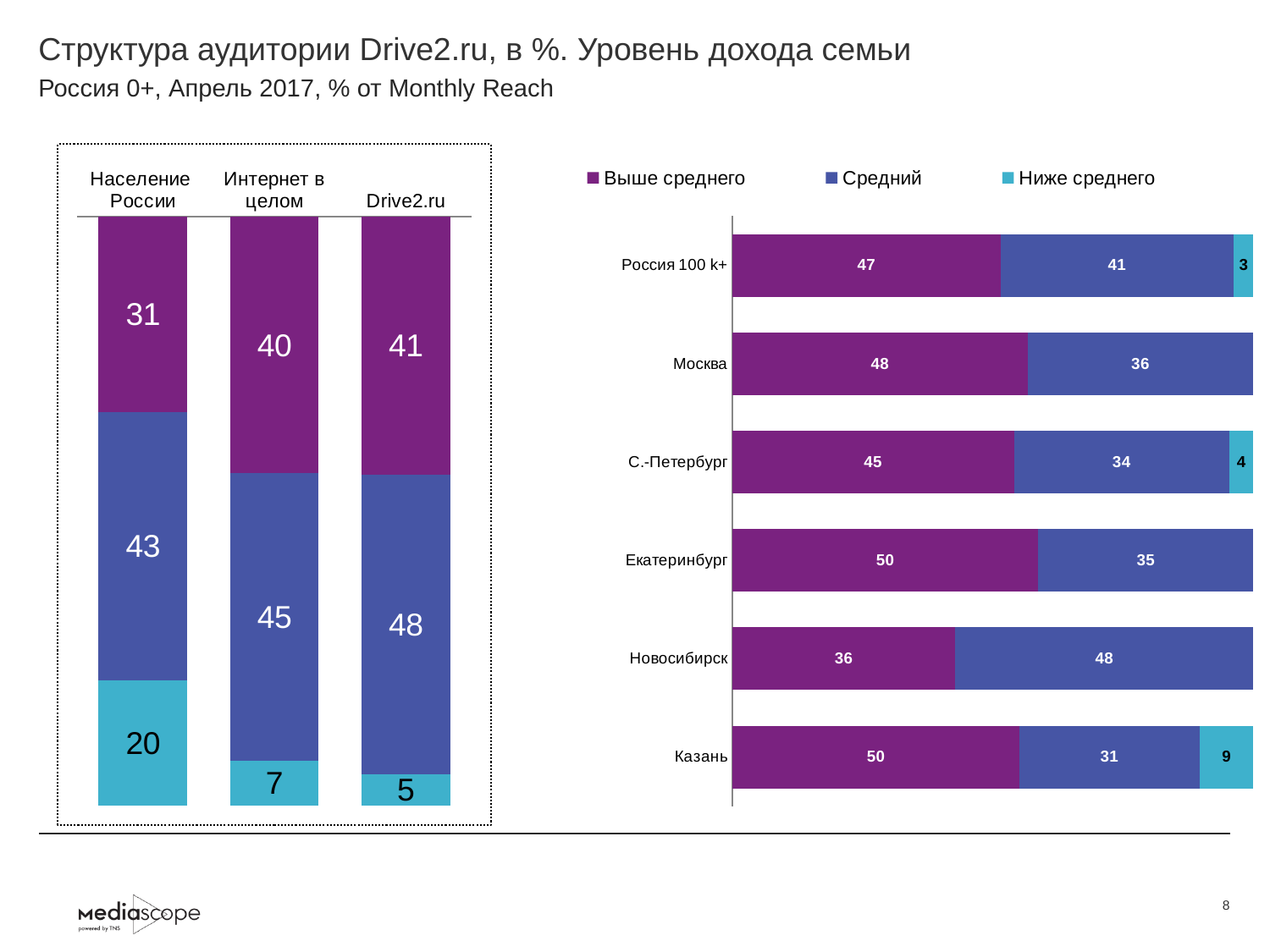
In the right chart, how many categories (regions/cities) are shown? 6 In the left chart, which category has the lowest 'Ниже среднего' value? Drive2.ru In the left chart, what is the value of the 'Выше среднего' segment for Drive2.ru? 41 In the left chart, what is the value of the 'Ниже среднего' segment for Население России? 20 In the right chart, which city has the highest 'Средний' value? Новосибирск In the left chart, what is the total of the stacked bar for Интернет в целом? 92 In the right chart, what is the 'Выше среднего' value for Новосибирск? 36 In the right chart, which has the larger 'Выше среднего' value: Москва or С.-Петербург? Москва In the left chart, what is the difference between the 'Средний' values for Drive2.ru and Население России? 5 In the right chart, what is the difference between the 'Выше среднего' and 'Средний' values for Екатеринбург? 15 In the right chart, what is the 'Ниже среднего' value for Казань? 9 How many series does the legend on the right list? 3